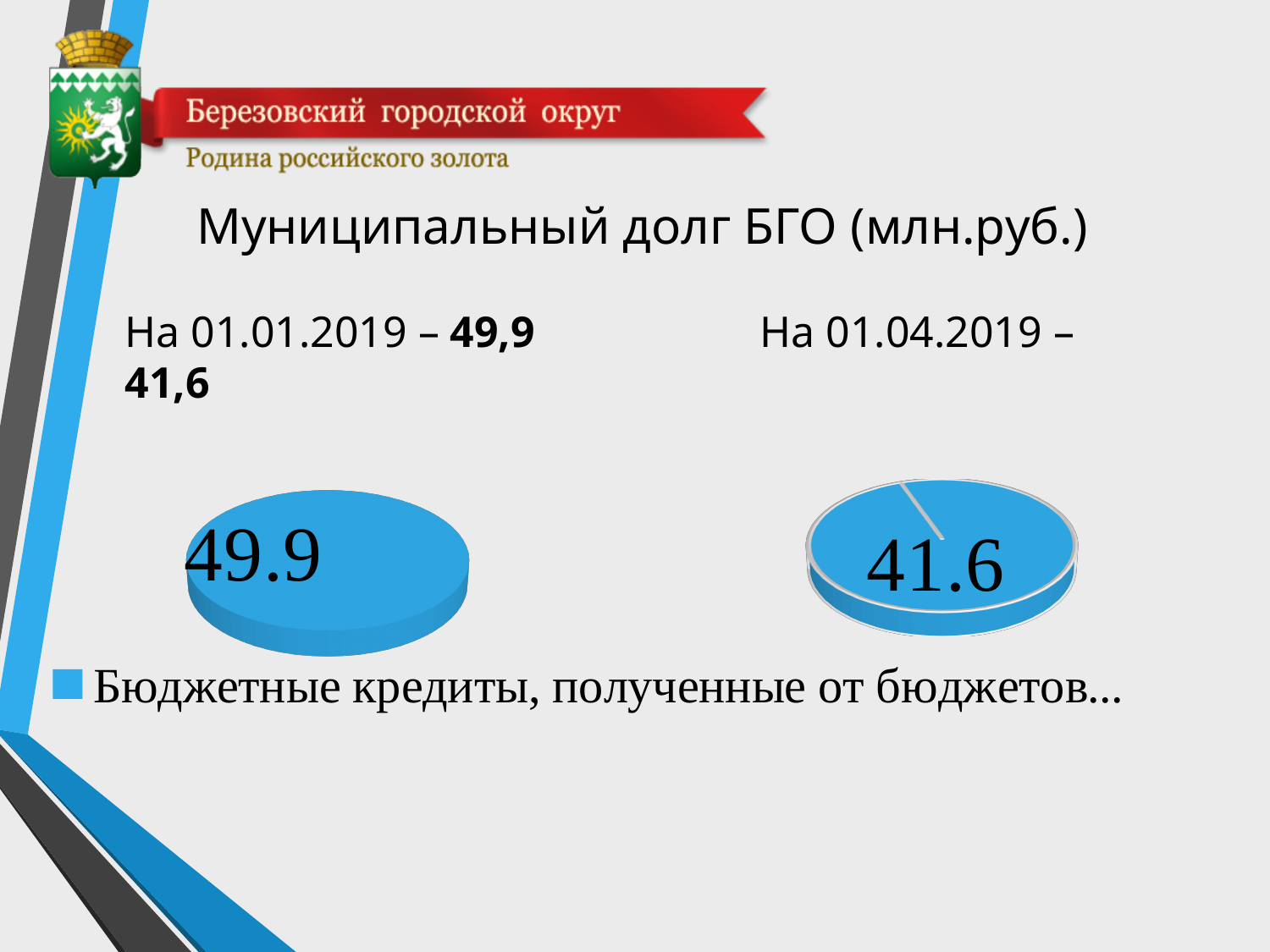
Is the value on the right pie chart greater or less than 45? less What type of chart is the right chart on the slide? pie chart How many series does the legend below the pie charts list? 1 What type of chart is the left chart on the slide? pie chart Did the municipal debt rise or fall from 01.01.2019 to 01.04.2019 according to the two pie charts? fall What value is shown on the right pie chart (as of 01.04.2019)? 41.6 What value is shown on the left pie chart (as of 01.01.2019)? 49.9 Is the value on the left pie chart greater or less than 45? greater Which is larger, the value on the left pie chart or the value on the right pie chart? the left pie chart (49.9) What is the title of the slide above the two pie charts? Муниципальный долг БГО (млн.руб.) What is the difference between the value on the left pie chart and the value on the right pie chart? 8.3 What legend entry is shown below the pie charts? Бюджетные кредиты, полученные от бюджетов...